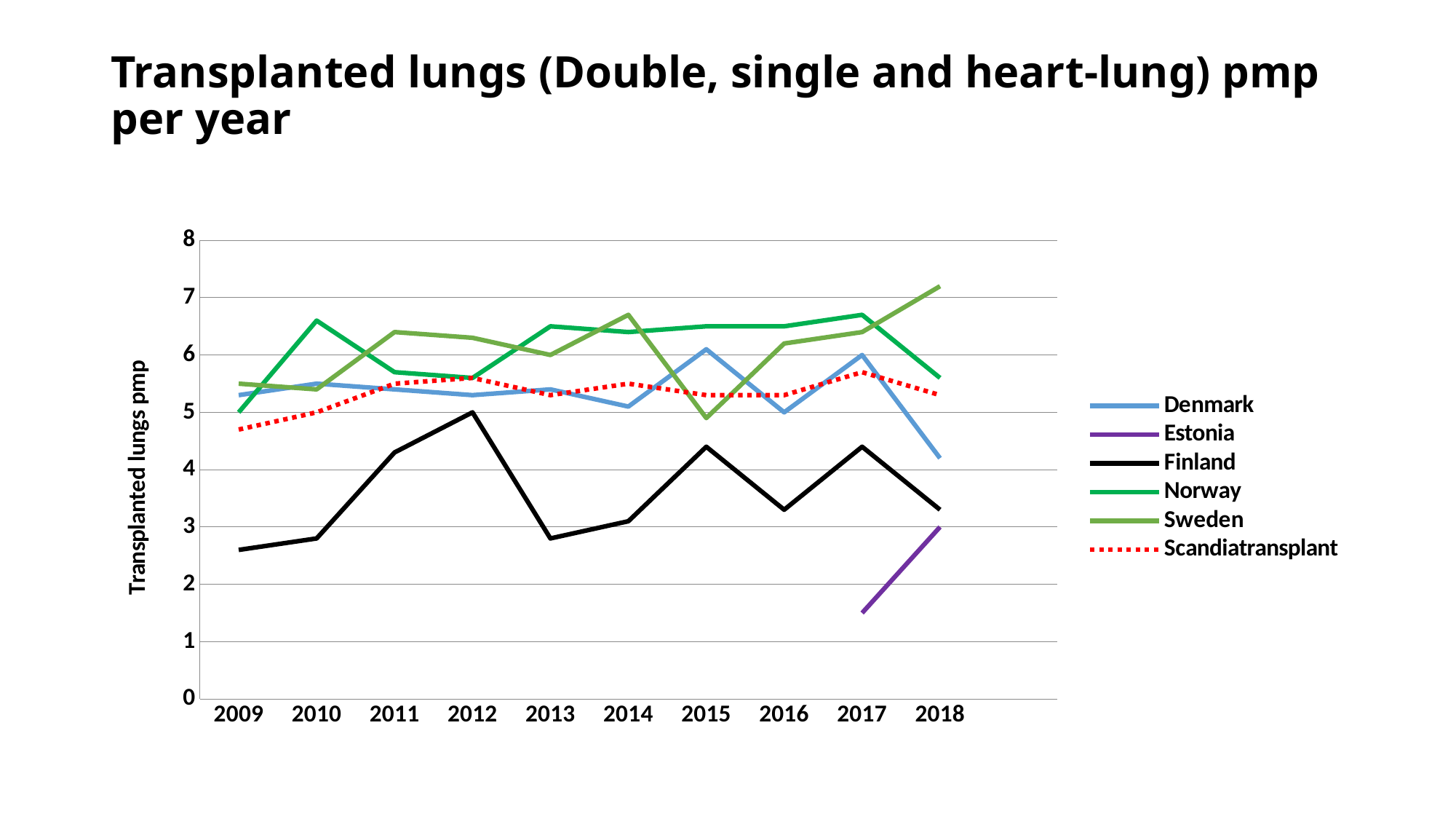
Is the value for Finland in 2009 greater or less than 3? less How many years are shown on the x axis? 10 Which series has the highest value in 2018? Sweden Is the value for Norway in 2010 greater or less than 6? greater How many series does the legend list? 6 Which series has the lowest value in 2018? Estonia Is the value for Estonia in 2017 greater or less than 2? less Which series is drawn with a dotted line? Scandiatransplant Does the value for Finland rise or fall from 2009 to 2012? rise What kind of chart is shown on the slide? line chart In 2011, which is larger, the value for Norway or the value for Finland? Norway